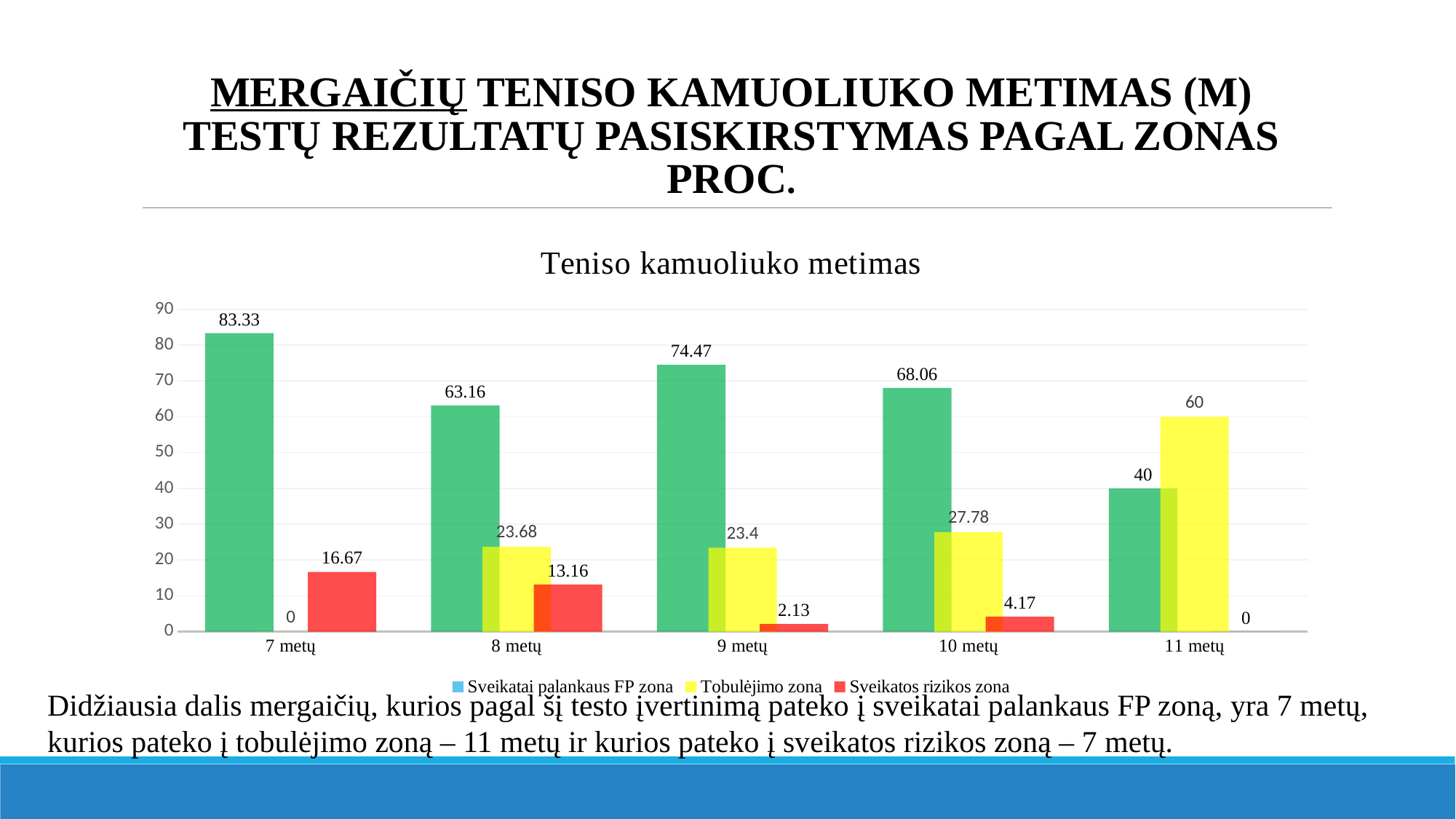
Which age group has the lowest value for Sveikatai palankaus FP zona? 11 metų Which age group has the highest value for Sveikatai palankaus FP zona? 7 metų What is the value for Tobulėjimo zona for 10 metų? 27.78 Is the value for Sveikatai palankaus FP zona for 10 metų greater or less than 60? greater How many series does the legend list? 3 For 11 metų, which is larger: Tobulėjimo zona or Sveikatai palankaus FP zona? Tobulėjimo zona What is the value for Sveikatai palankaus FP zona for 7 metų? 83.33 What is the difference between the Sveikatai palankaus FP zona values for 9 metų and 8 metų? 11.31 What type of chart is shown on the slide? bar chart How many age groups are shown on the x axis? 5 What is the value for Sveikatos rizikos zona for 9 metų? 2.13 What is the chart's title? Teniso kamuoliuko metimas